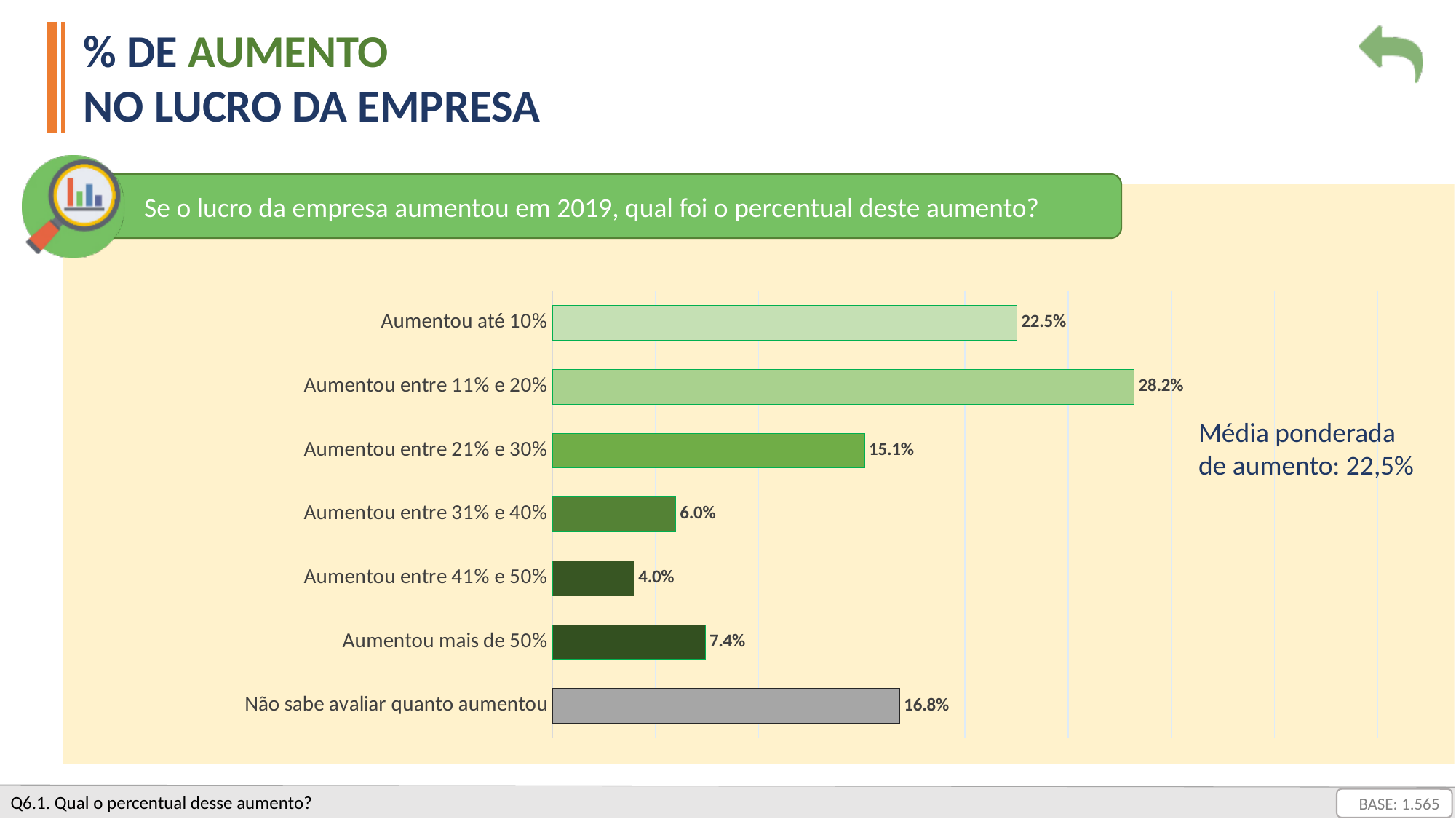
What kind of chart is shown on the slide? Bar chart Which category has the lowest value? Aumentou entre 41% e 50% What is the base (BASE) shown on the slide? 1.565 What is the value for "Aumentou até 10%"? 22.5% What is the difference between the values for "Aumentou entre 11% e 20%" and "Aumentou até 10%"? 5.7% Which is larger: the value for "Aumentou entre 31% e 40%" or for "Aumentou mais de 50%"? Aumentou mais de 50% What is the value for "Aumentou entre 21% e 30%"? 15.1% What is the weighted average increase (média ponderada de aumento) stated next to the chart? 22,5% Which category has the highest value? Aumentou entre 11% e 20% How many categories are shown in the chart? 7 What is the value for "Aumentou mais de 50%"? 7.4% What is the value for "Não sabe avaliar quanto aumentou"? 16.8%